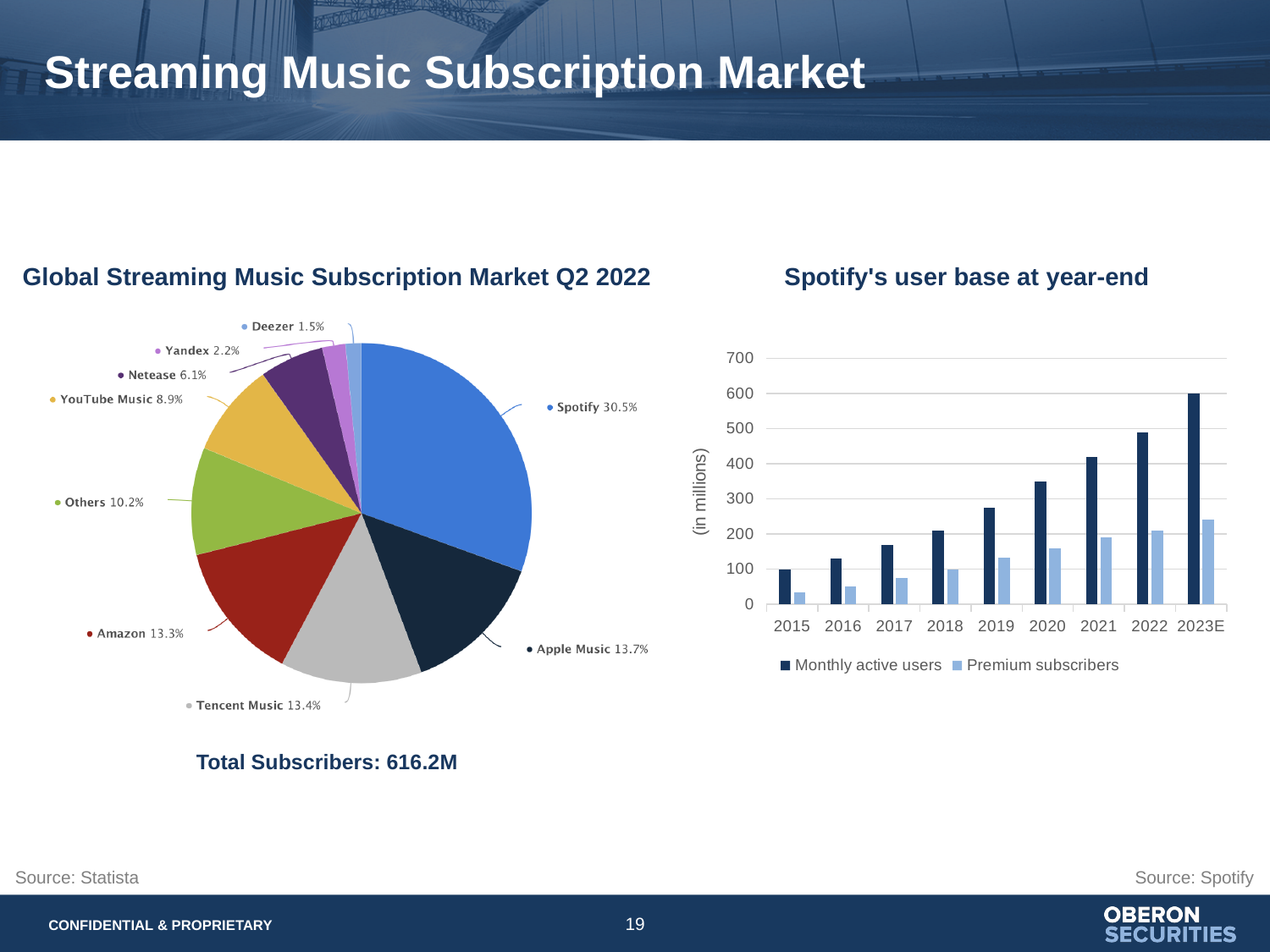
In the Global Streaming Music Subscription Market Q2 2022 pie chart, which has the larger share, Amazon or Netease? Amazon In the Global Streaming Music Subscription Market Q2 2022 pie chart, what share does YouTube Music hold? 8.9% How many slices does the Global Streaming Music Subscription Market Q2 2022 pie chart have? 9 In the Global Streaming Music Subscription Market Q2 2022 pie chart, what share does Spotify hold? 30.5% What total subscriber figure is shown beneath the Global Streaming Music Subscription Market Q2 2022 pie chart? 616.2M In the Global Streaming Music Subscription Market Q2 2022 pie chart, how many percentage points larger is Spotify's share than Apple Music's? 16.8% What type of chart is 'Spotify's user base at year-end'? Bar chart In the Global Streaming Music Subscription Market Q2 2022 pie chart, which service has the largest share? Spotify In the Global Streaming Music Subscription Market Q2 2022 pie chart, which service has the smallest share? Deezer In the 'Spotify's user base at year-end' chart, do Monthly active users rise or fall from 2015 to 2023E? Rise In the 'Spotify's user base at year-end' chart, is the value for Monthly active users in 2023E greater or less than 500? greater How many series does the legend of the 'Spotify's user base at year-end' chart list? 2